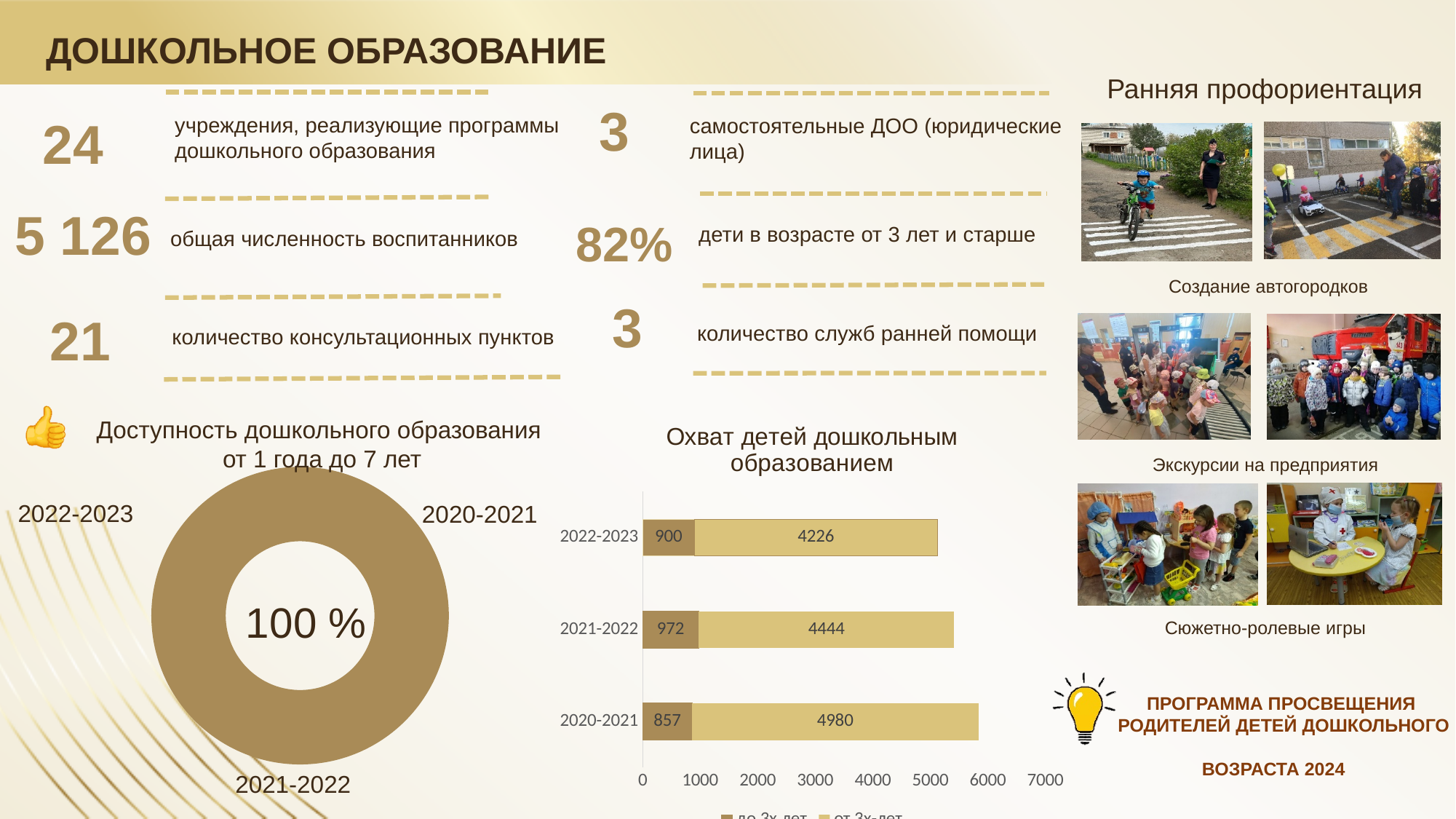
In the chart 'Охват детей дошкольным образованием', what is the total of the stacked bar for 2020-2021? 5837 In the chart 'Охват детей дошкольным образованием', is the 'от 3х лет' value for 2021-2022 larger or smaller than for 2022-2023? larger In the chart 'Охват детей дошкольным образованием', what is the value of the 'от 3х лет' segment for 2020-2021? 4980 In the chart 'Охват детей дошкольным образованием', which year has the highest 'от 3х лет' value? 2020-2021 In the chart 'Охват детей дошкольным образованием', what is the difference between the 'от 3х лет' values for 2020-2021 and 2022-2023? 754 In the chart 'Охват детей дошкольным образованием', which year has the lowest 'до 3х лет' value? 2020-2021 In the chart 'Охват детей дошкольным образованием', what is the value of the 'до 3х лет' segment for 2022-2023? 900 In the chart 'Охват детей дошкольным образованием', what is the value of the 'до 3х лет' segment for 2021-2022? 972 What percentage is shown in the centre of the donut chart 'Доступность дошкольного образования от 1 года до 7 лет'? 100 % In the chart 'Охват детей дошкольным образованием', what is the total of the stacked bar for 2022-2023? 5126 How many year categories are shown in the chart 'Охват детей дошкольным образованием'? 3 What type of chart is 'Охват детей дошкольным образованием'? stacked bar chart